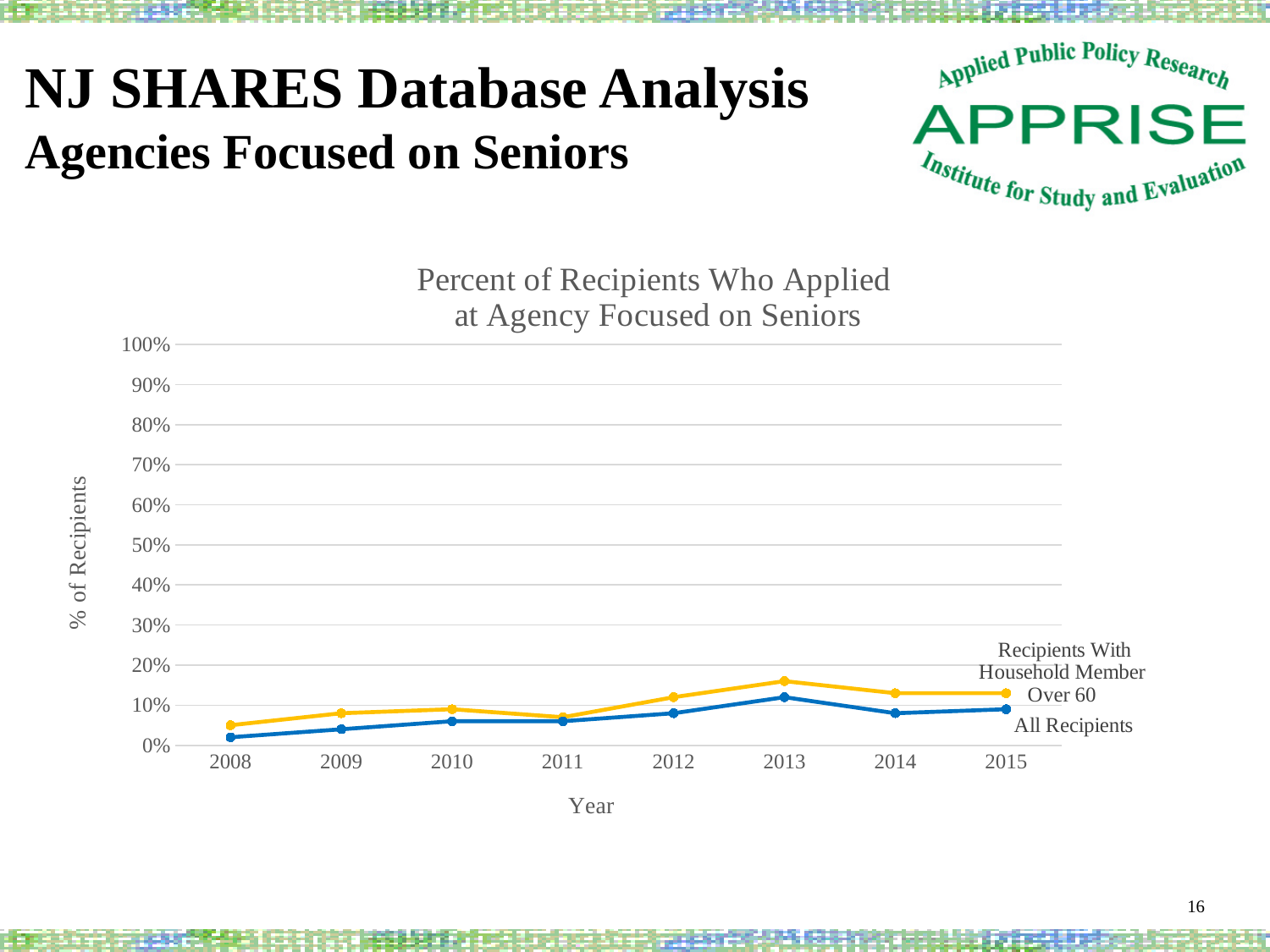
In which year is the value for All Recipients highest? 2013 How many years are plotted along the x axis? 8 In 2013, which series has the higher value: Recipients With Household Member Over 60 or All Recipients? Recipients With Household Member Over 60 Is the value for All Recipients in 2008 greater or less than 10%? less Is the value for Recipients With Household Member Over 60 in 2013 greater or less than 10%? greater How many series does the chart show? 2 Is the value for Recipients With Household Member Over 60 in 2015 greater or less than 20%? less What kind of chart is shown on the slide? line chart In which year is the value for Recipients With Household Member Over 60 lowest? 2008 In which year is the value for Recipients With Household Member Over 60 highest? 2013 Do the values for All Recipients rise or fall from 2008 to 2013? rise In which year is the value for All Recipients lowest? 2008